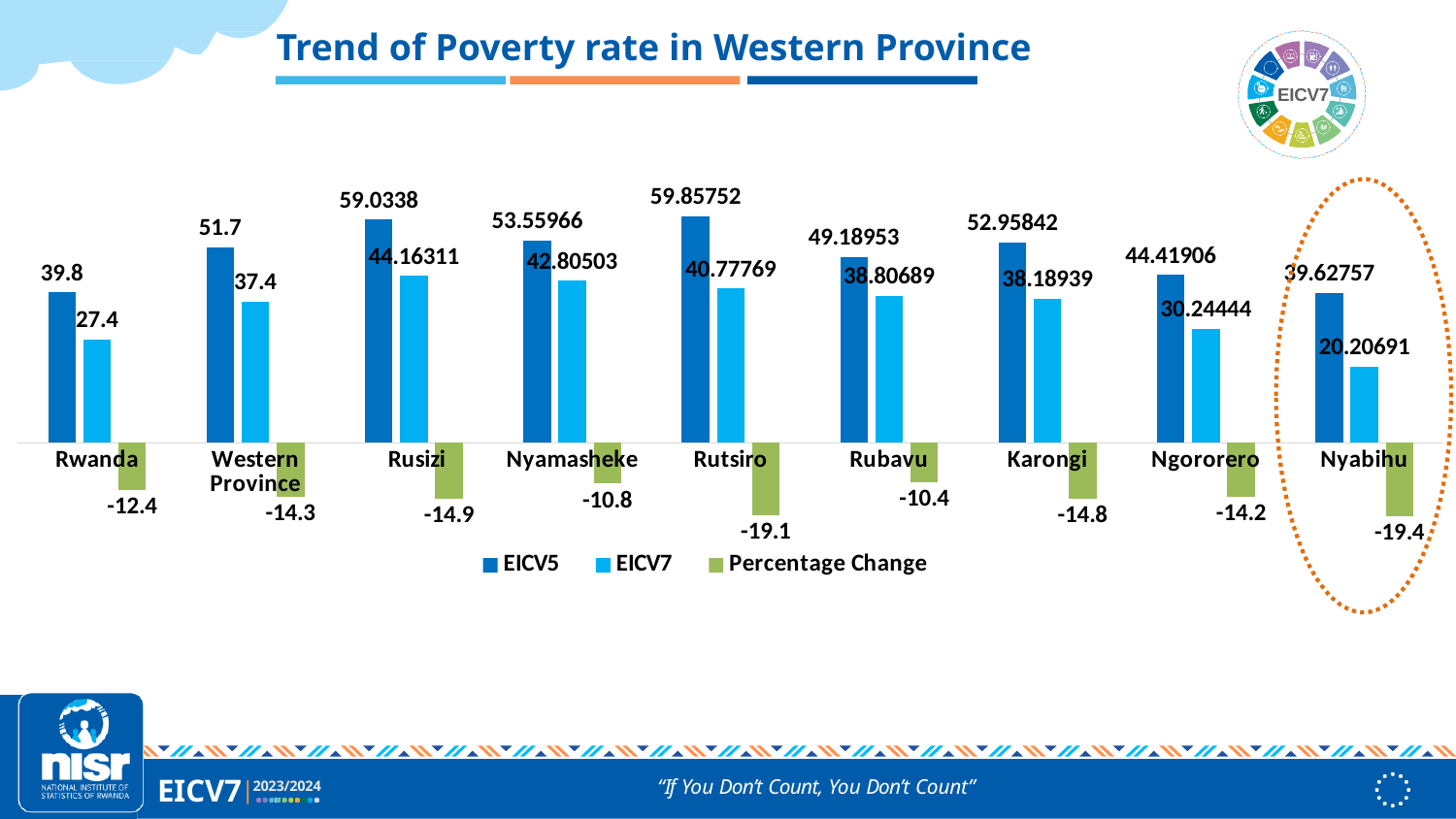
What is the Percentage Change value for Rutsiro? -19.1 What kind of chart is shown on the slide? Bar chart Which is larger, the EICV7 value for Rusizi or the EICV7 value for Ngororero? Rusizi What is the EICV7 poverty rate for Nyabihu? 20.20691 How many series does the legend list? 3 What is the difference between the EICV5 and EICV7 values for Rwanda? 12.4 What is the EICV7 value for Western Province? 37.4 What is the title of the chart? Trend of Poverty rate in Western Province Which category has the lowest EICV7 value? Nyabihu How many categories are shown on the x axis? 9 Which category has the highest EICV5 value? Rutsiro What is the EICV5 poverty rate for Rusizi? 59.0338